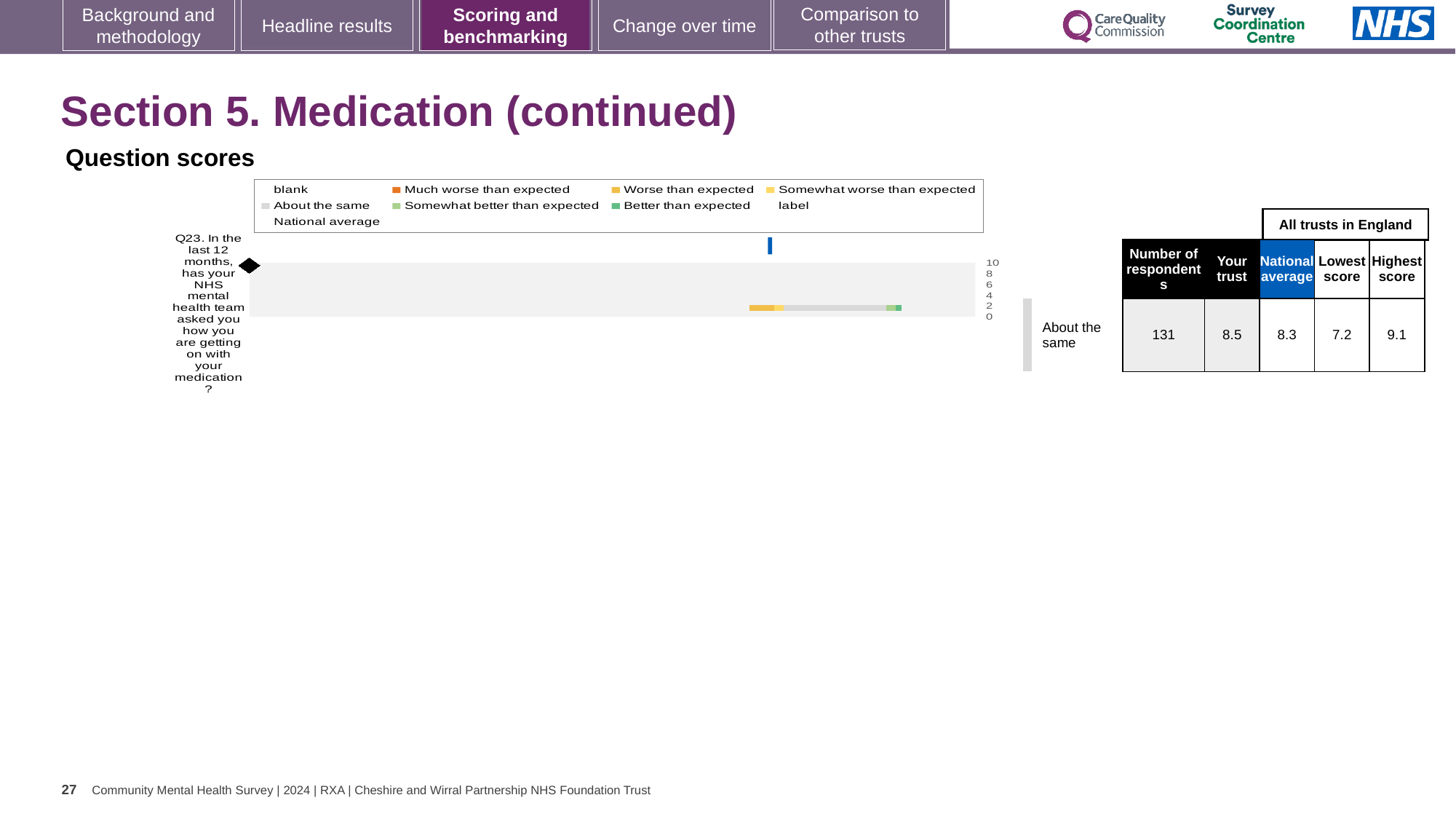
How many respondents answered Q23? 131 What is the difference between the highest and lowest trust scores for Q23? 1.9 Is the trust's score for Q23 greater or less than 8 on the chart axis? greater What kind of chart is used to show the Q23 question score? bar chart Which benchmarking category is the trust's Q23 result placed in? About the same What is the national average score for Q23? 8.3 Which is higher for Q23, the trust's score or the national average? Your trust What is the 'Your trust' score for Q23 shown on the slide? 8.5 What is the lowest score among all trusts in England for Q23? 7.2 What is the highest score among all trusts in England for Q23? 9.1 How many survey questions are plotted on the chart? 1 By how much does the trust's Q23 score exceed the national average? 0.2